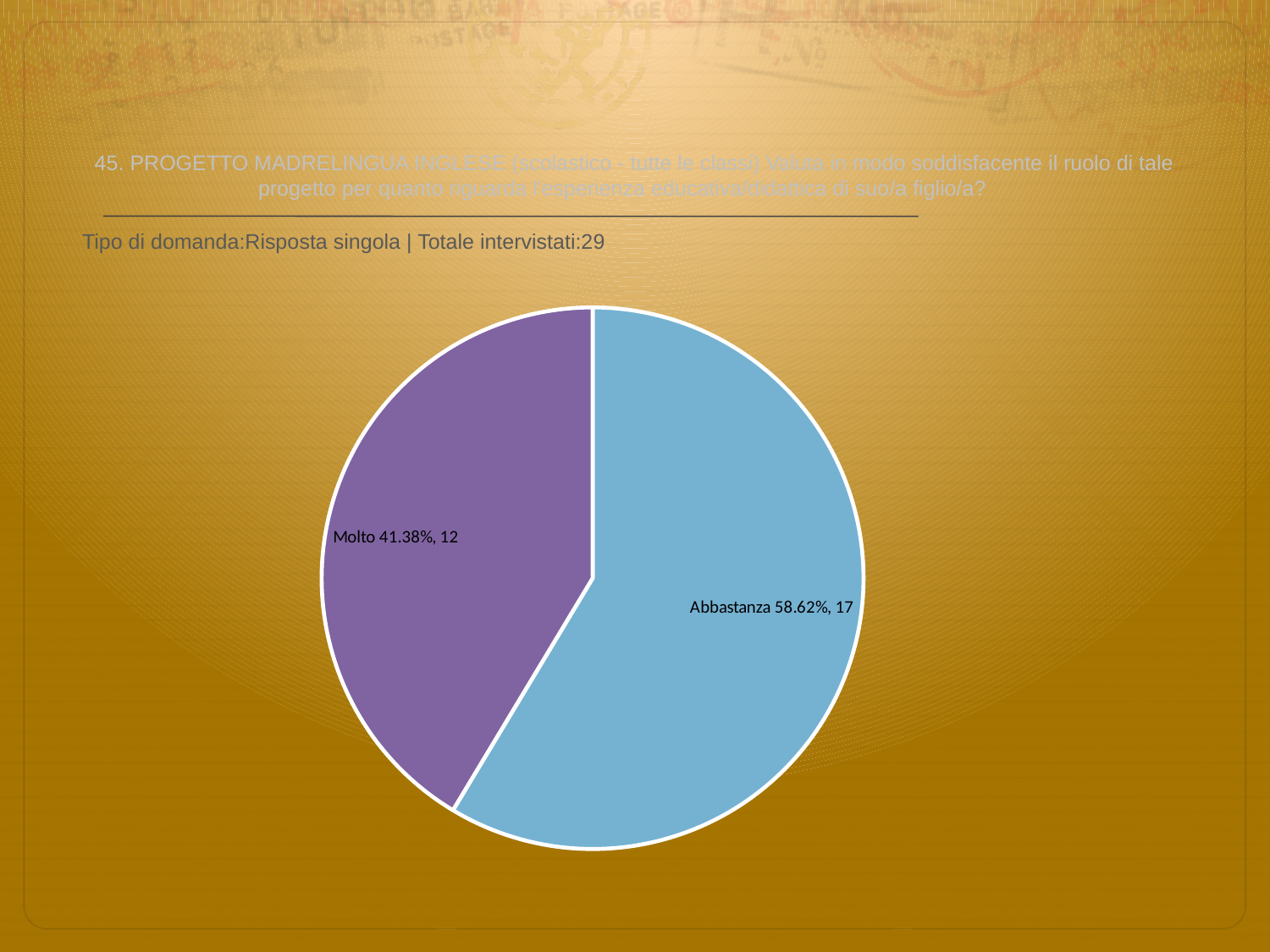
How many respondents answered Abbastanza? 17 How many respondents answered Molto? 12 Which has more respondents, Molto or Abbastanza? Abbastanza Which slice is the smallest in the pie chart? Molto What kind of chart is shown on the slide? pie chart What is the difference in respondent count between Abbastanza and Molto? 5 Which slice is the largest in the pie chart? Abbastanza How many slices does the pie chart have? 2 What percentage share does the Abbastanza slice have? 58.62% What colour is the Molto slice? purple What is the total number of respondents across both slices? 29 What percentage share does the Molto slice have? 41.38%